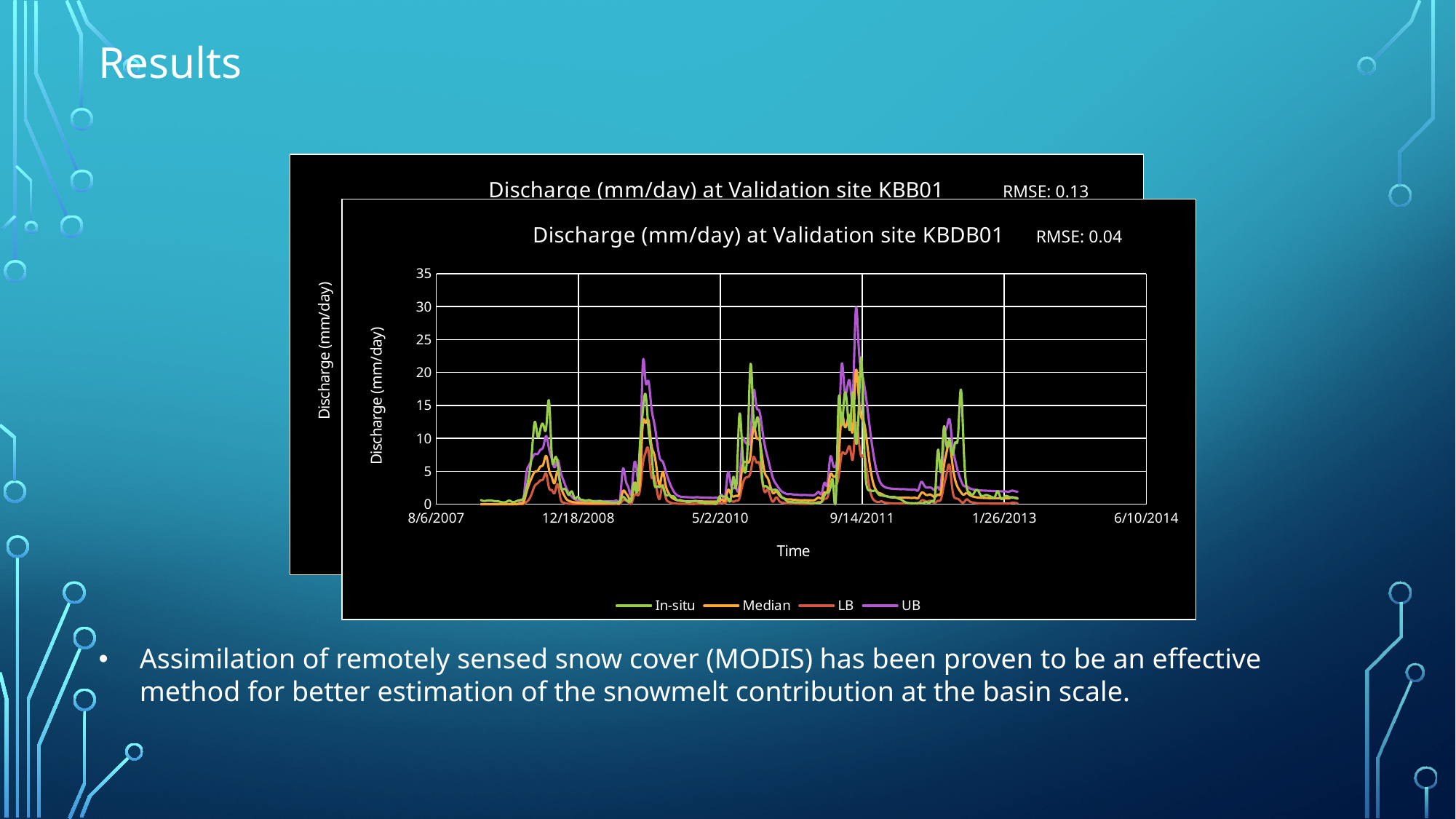
What is the title of the chart partly hidden behind the front chart? Discharge (mm/day) at Validation site KBB01 What RMSE value is shown on the front chart for Validation site KBDB01? RMSE: 0.04 How many series does the legend of the front chart (Validation site KBDB01) list? 4 What is the highest value shown on the y axis of the front chart (Validation site KBDB01)? 35 What kind of chart is the front chart titled 'Discharge (mm/day) at Validation site KBDB01'? line chart In the front chart (Validation site KBDB01), which series reaches the highest peak value? UB In the front chart (Validation site KBDB01), is the highest peak of the In-situ series greater or less than 25? less In the front chart (Validation site KBDB01), is the highest peak of the UB series greater or less than 25? greater How many date labels are shown on the x axis of the front chart (Validation site KBDB01)? 6 In the front chart (Validation site KBDB01), is the highest peak of the LB series greater or less than 15? less In the front chart (Validation site KBDB01), which series has the higher peak, UB or LB? UB